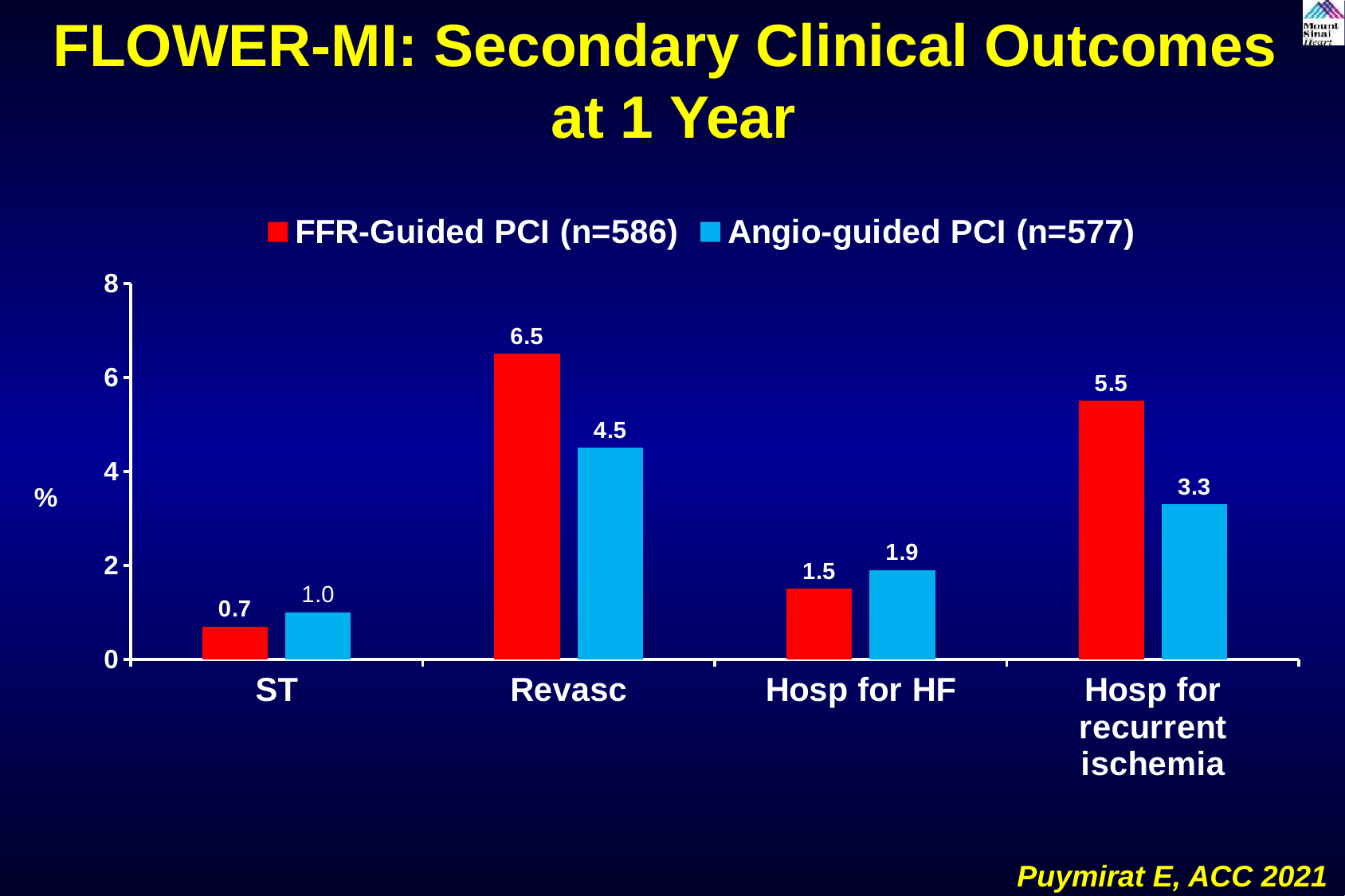
How many categories are shown on the x axis? 4 Is the value for FFR-Guided PCI in the Hosp for recurrent ischemia category greater or less than 4? greater Which category has the lowest value for Angio-guided PCI? ST What is the difference between the FFR-Guided PCI and Angio-guided PCI values in the Revasc category? 2.0 What kind of chart is shown on the slide? Bar chart In the Hosp for HF category, which series has the larger value, FFR-Guided PCI or Angio-guided PCI? Angio-guided PCI What is the difference between the Angio-guided PCI and FFR-Guided PCI values in the Hosp for HF category? 0.4 Which category has the highest value for FFR-Guided PCI? Revasc What is the value for FFR-Guided PCI in the Revasc category? 6.5 What is the value for Angio-guided PCI in the ST category? 1.0 How many series does the legend list? 2 What is the value for Angio-guided PCI in the Hosp for recurrent ischemia category? 3.3